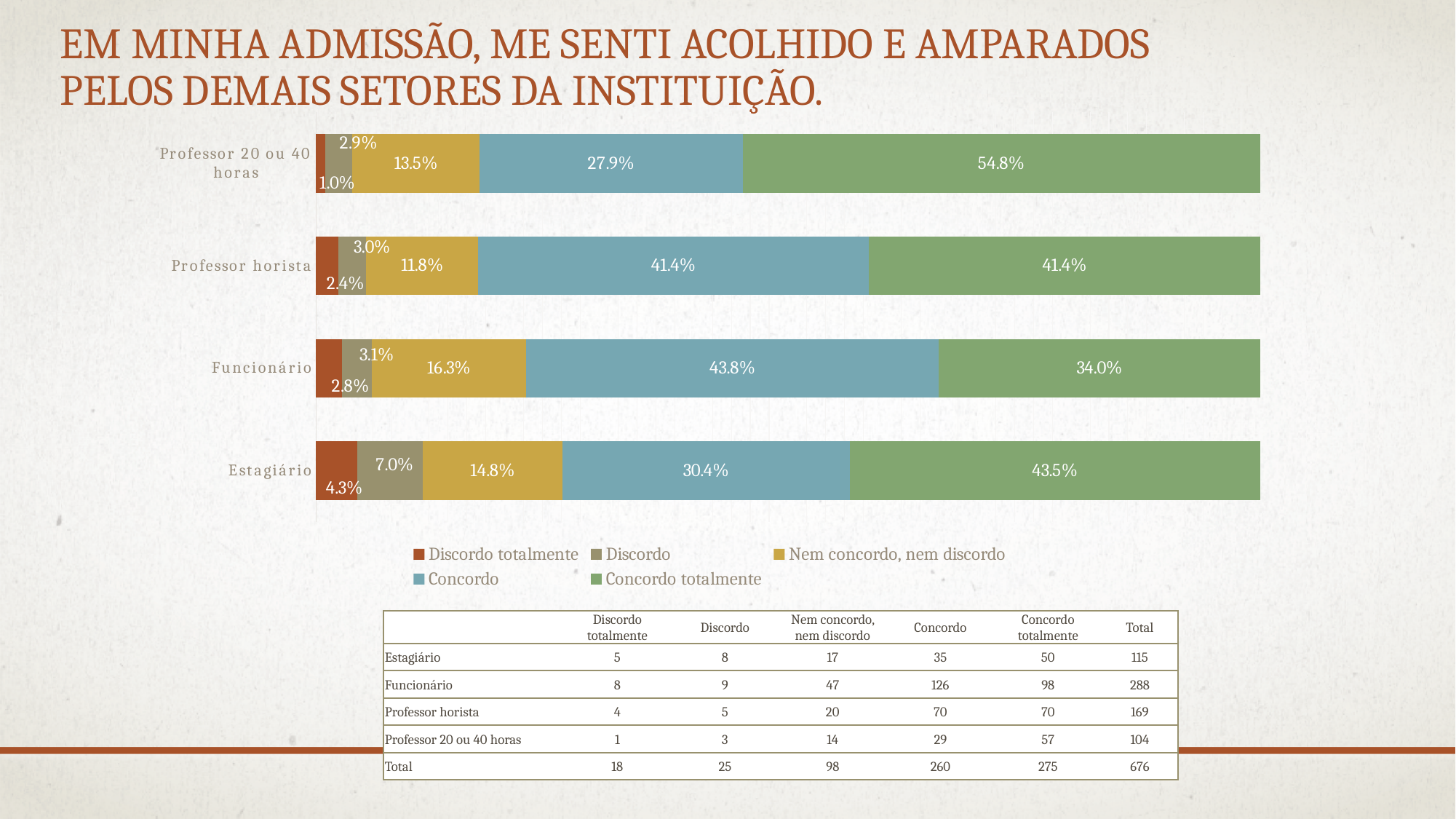
Which series is shown in green in the legend? Concordo totalmente Which is larger: the Concordo value for Professor horista or the Concordo value for Estagiário? Professor horista How many series does the legend list? 5 How many categories are shown on the chart? 4 What is the difference in percentage points between the Concordo totalmente values for Professor 20 ou 40 horas and Estagiário? 11.3 Which category has the lowest Discordo totalmente percentage? Professor 20 ou 40 horas What percentage of Estagiário respondents answered Discordo? 7.0% What percentage of Professor 20 ou 40 horas respondents answered Concordo totalmente? 54.8% What kind of chart is shown on the slide? Stacked bar chart What is the Concordo value for Funcionário? 43.8% Which category has the highest Concordo totalmente percentage? Professor 20 ou 40 horas What is the Nem concordo, nem discordo value for Professor horista? 11.8%